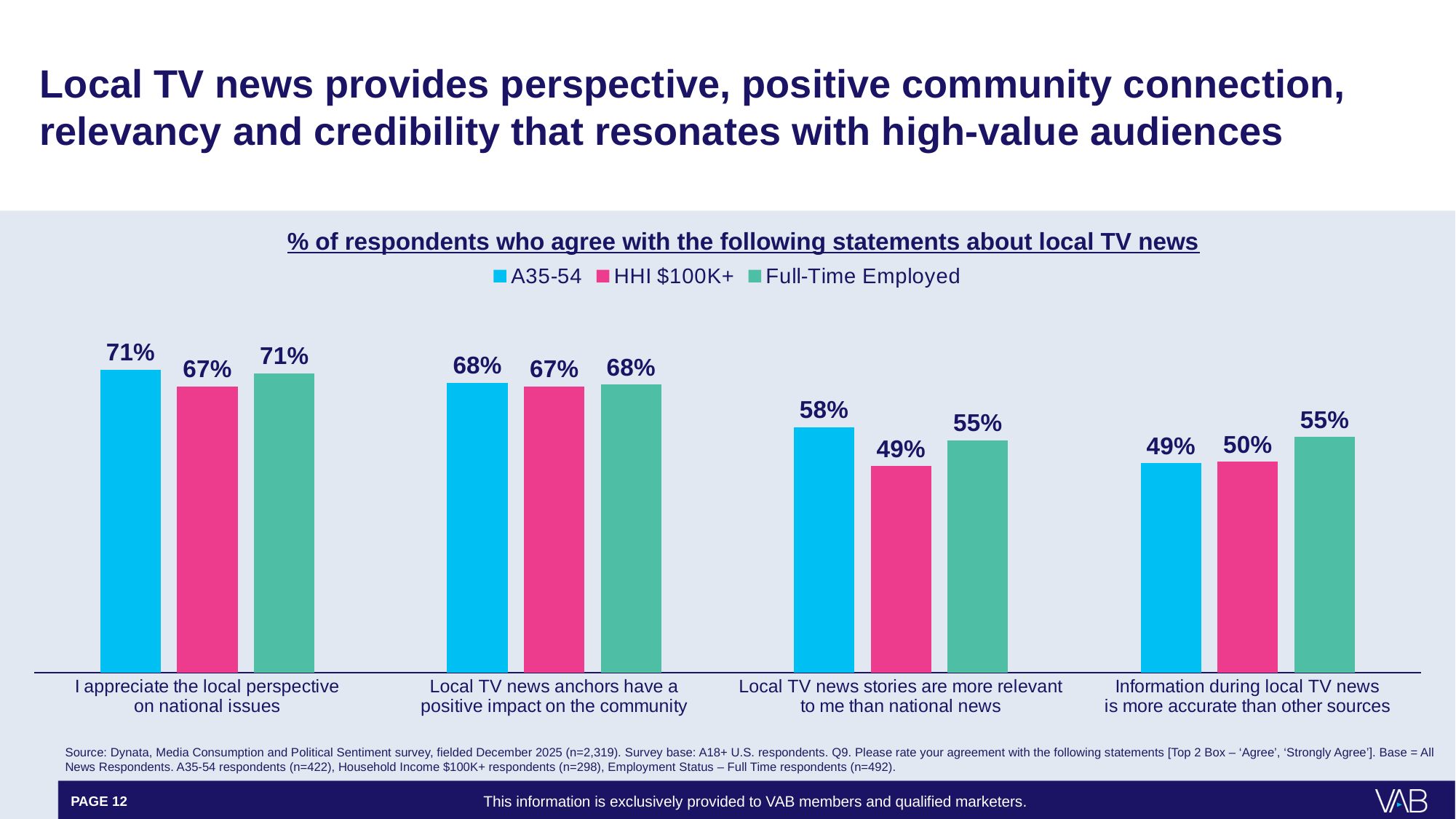
Do the A35-54 values rise or fall from the first statement to the last statement along the x axis? Fall What is the difference between the A35-54 and HHI $100K+ values for the statement that local TV news stories are more relevant than national news? 9 percentage points For the statement that local TV news anchors have a positive impact on the community, which group has the higher value: A35-54 or HHI $100K+? A35-54 How many series does the legend list? 3 How many statements are shown on the x axis of the chart? 4 What percentage of HHI $100K+ respondents agree that local TV news stories are more relevant to them than national news? 49% What kind of chart is shown on the slide? Bar chart What percentage of A35-54 respondents agree that they appreciate the local perspective on national issues? 71% What colour represents the Full-Time Employed series in the chart? Green Which statement has the highest agreement among HHI $100K+ respondents? Two statements tie at 67%: "I appreciate the local perspective on national issues" and "Local TV news anchors have a positive impact on the community" What percentage of Full-Time Employed respondents agree that information during local TV news is more accurate than other sources? 55% Which statement has the lowest agreement among A35-54 respondents? Information during local TV news is more accurate than other sources